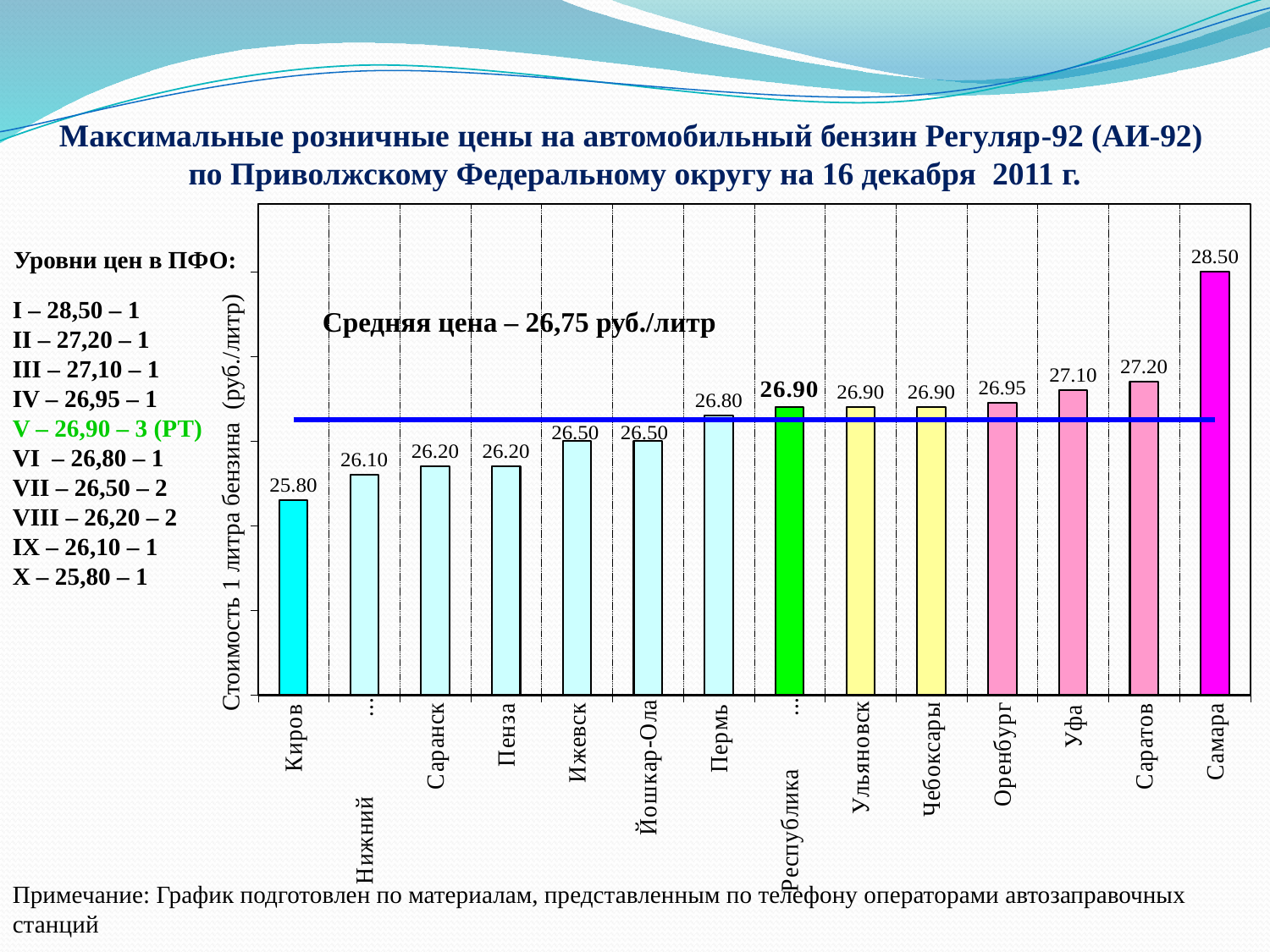
What is the value for Киров? 25.80 What kind of chart is shown on the slide? bar chart What is the difference between the values for Саратов and Уфа? 0.10 How many bars are plotted in the chart? 14 What is the value for Самара? 28.50 What average price is stated in the text inside the chart? 26,75 руб./литр Which city has the lowest value? Киров Which city has the highest value? Самара What is the value for Пермь? 26.80 What is the difference between the values for Самара and Киров? 2.70 Which is larger, the value for Ижевск or the value for Пенза? Ижевск What is the value for Оренбург? 26.95